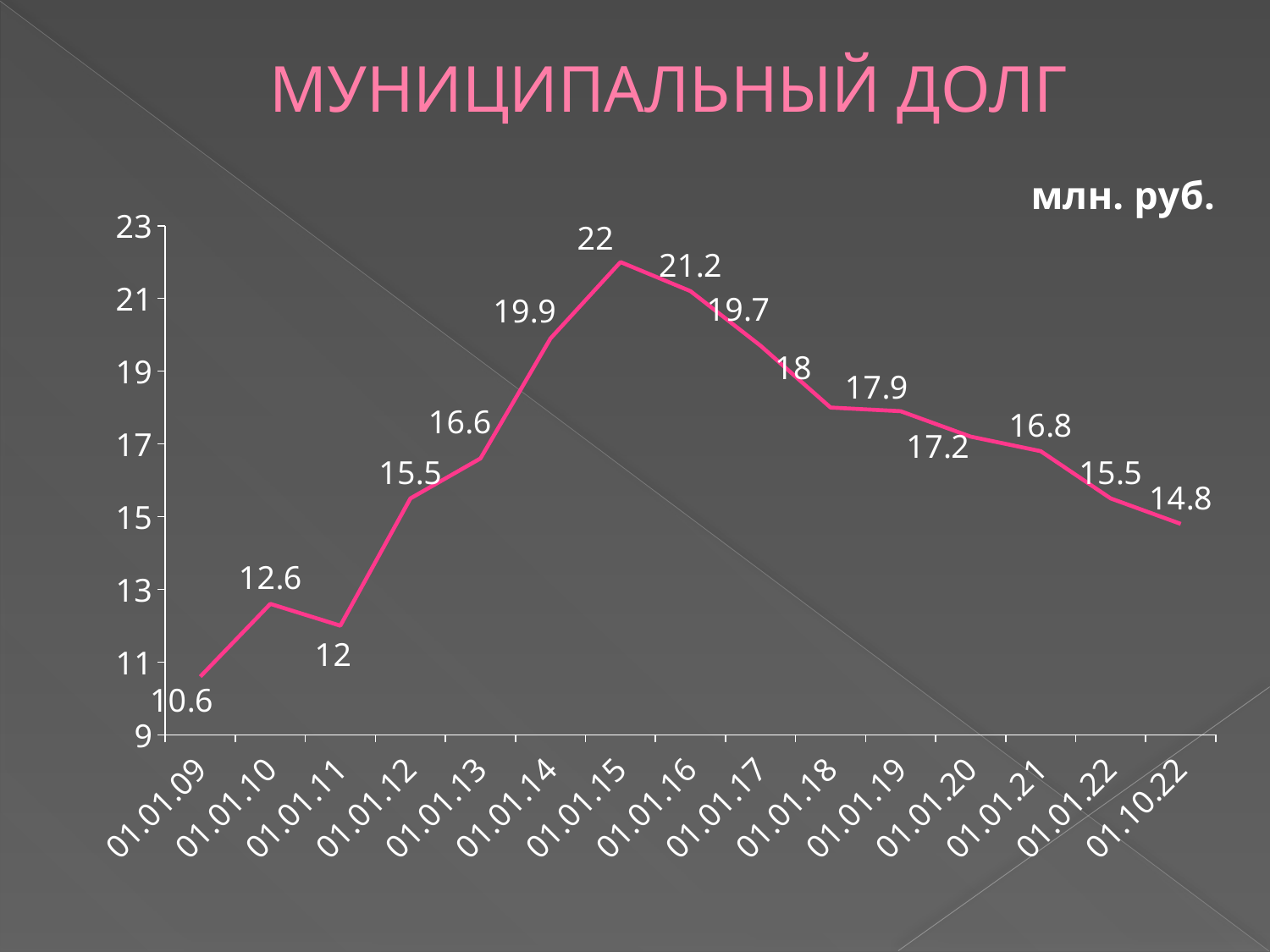
Which date has the highest value? 01.01.15 What is the value for 01.01.09? 10.6 What is the value for 01.10.22? 14.8 Which is larger, the value for 01.01.14 or the value for 01.01.17? 01.01.14 What is the difference between the values for 01.01.15 and 01.01.09? 11.4 How many data points are plotted on the chart? 15 What is the value for 01.01.19? 17.9 Which date has the lowest value? 01.01.09 What is the value for 01.01.15? 22 What is the title of the chart? МУНИЦИПАЛЬНЫЙ ДОЛГ What type of chart is shown on the slide? line chart Do the values rise or fall from 01.01.15 to 01.10.22? fall